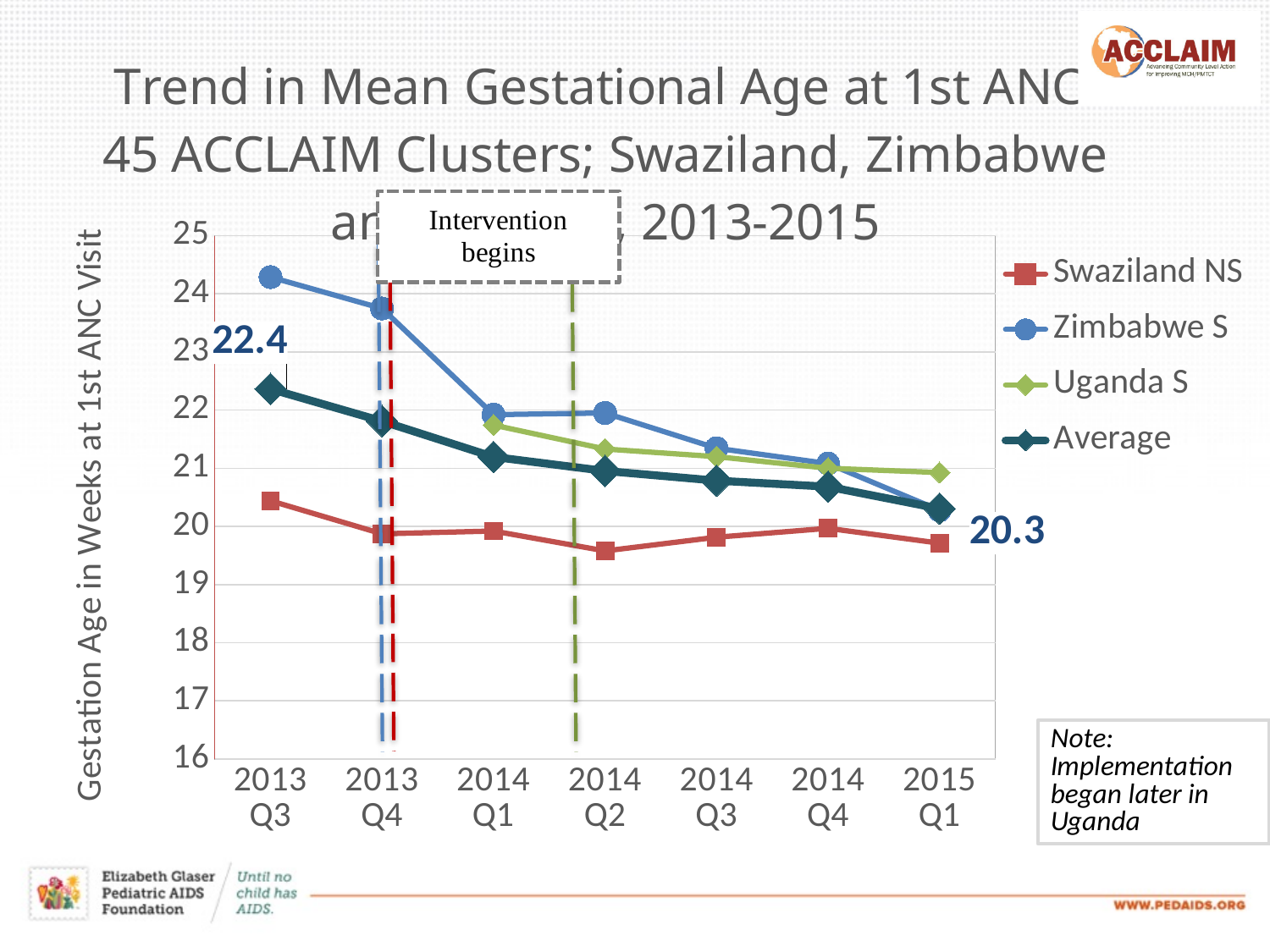
By how much did the Average value fall from 2013 Q3 to 2015 Q1? 2.1 What is the Average gestational age at 2015 Q1? 20.3 How many series does the legend list? 4 Does the Average line rise or fall from 2013 Q3 to 2015 Q1? fall What kind of chart is shown on the slide? line chart Is the value for Swaziland NS at 2014 Q2 greater or less than 20? less Which series has the lowest value at 2013 Q3? Swaziland NS Is the value for Zimbabwe S at 2013 Q3 greater or less than 24? greater What is the Average gestational age at 2013 Q3? 22.4 At 2014 Q3, which is larger: Zimbabwe S or Swaziland NS? Zimbabwe S Which series has the highest value at 2013 Q3? Zimbabwe S How many quarters are shown along the x axis? 7